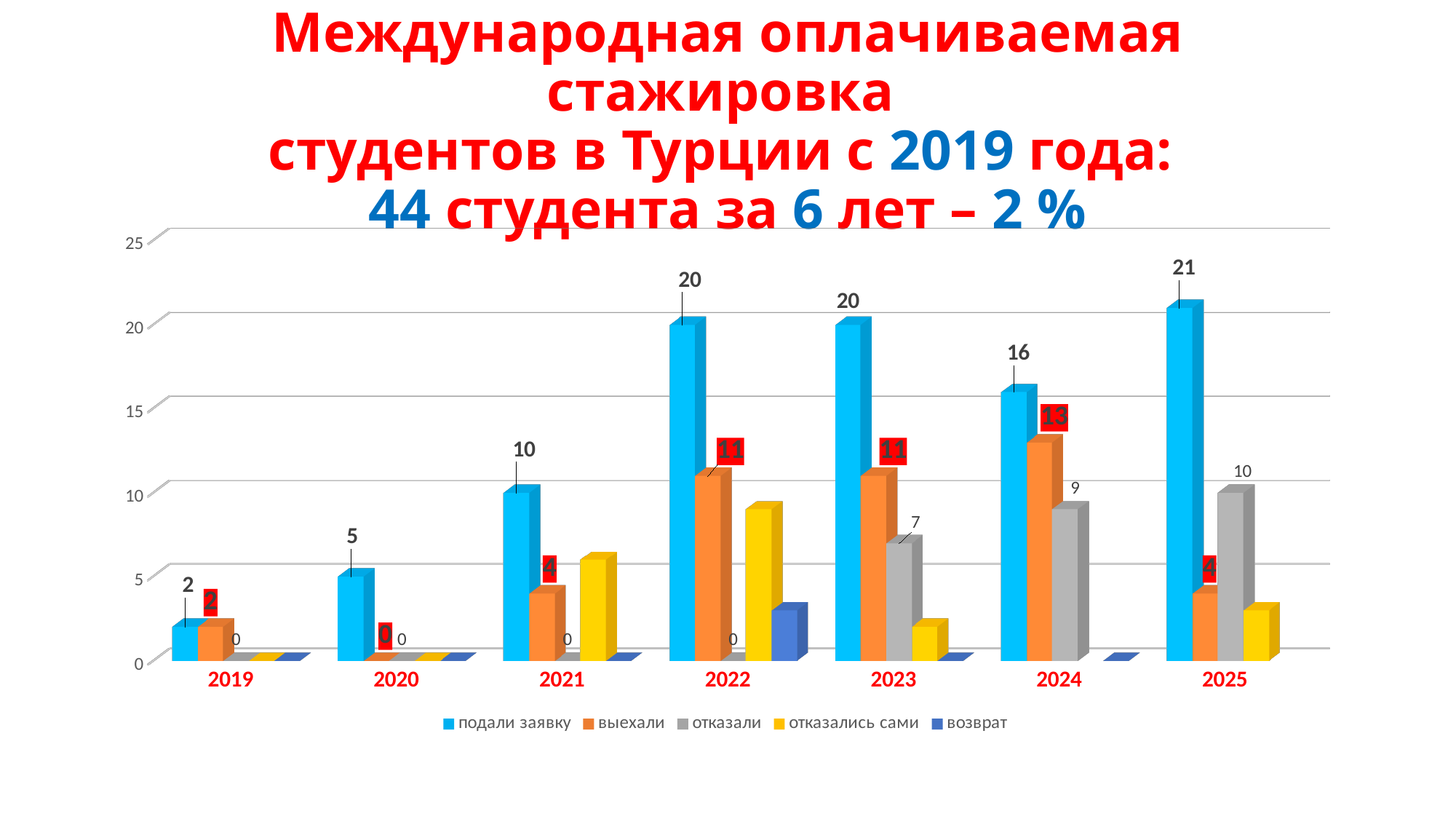
What is the difference between подали заявку and выехали in 2022? 9 What kind of chart is shown on the slide? bar chart In which year is the value for подали заявку the lowest? 2019 How many years are shown on the x axis? 7 Is the value for возврат in 2022 greater or less than 5? less Is the value for отказались сами in 2022 greater or less than 5? greater What is the value for отказали in 2023? 7 How many series does the legend list? 5 In which year is the value for подали заявку the highest? 2025 Which year has the larger value for выехали, 2023 or 2024? 2024 What is the value for подали заявку in 2025? 21 What is the value for выехали in 2024? 13